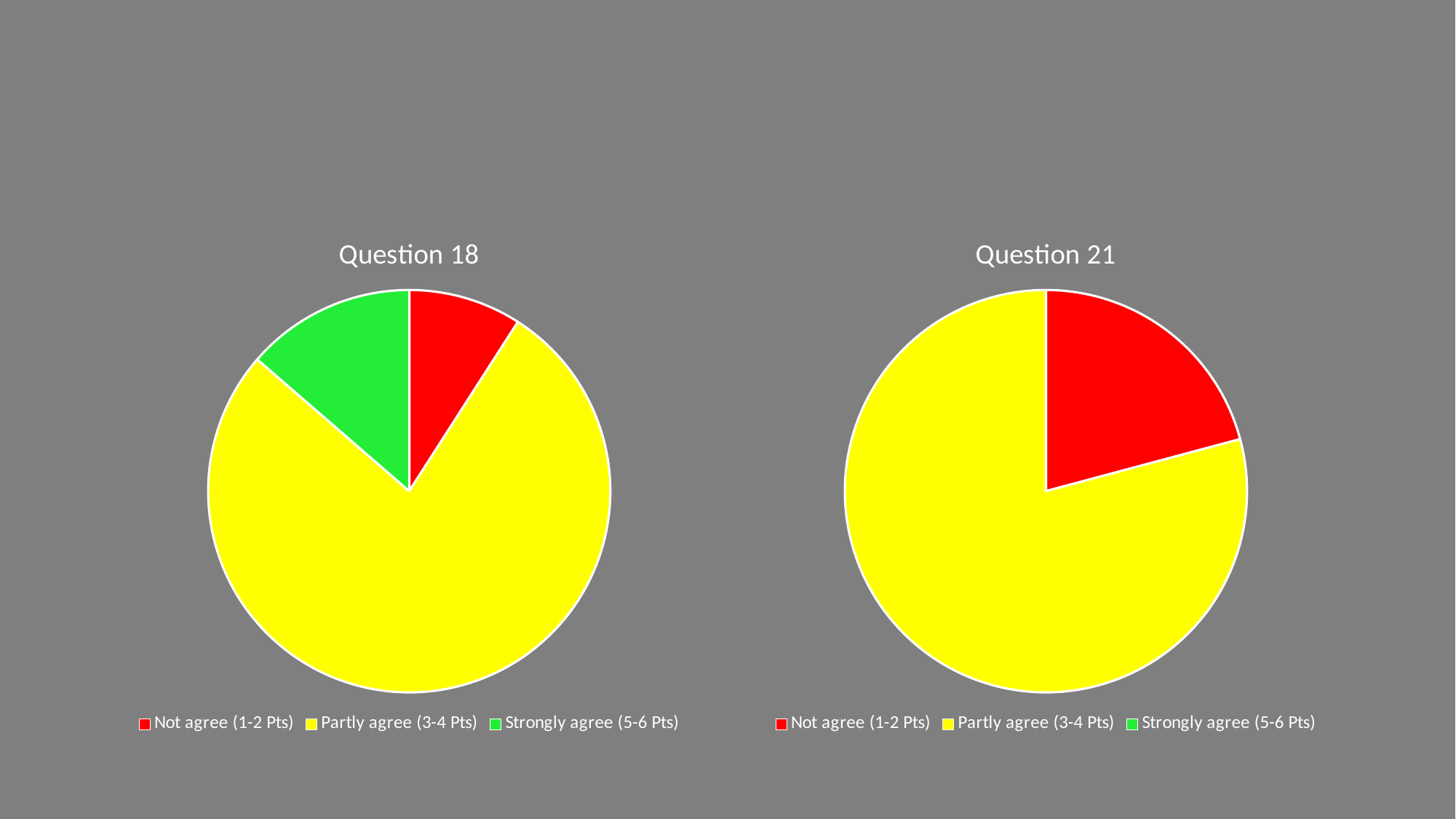
What kind of chart is used for Question 18? pie chart In the Question 21 chart, which category has the largest slice? Partly agree (3-4 Pts) How many slices are visible in the Question 21 pie chart? 2 What is the title of the chart on the right side of the slide? Question 21 How many slices are visible in the Question 18 pie chart? 3 In the Question 21 chart, which slice is larger: Partly agree (3-4 Pts) or Not agree (1-2 Pts)? Partly agree (3-4 Pts) In the Question 18 chart, which slice is larger: Strongly agree (5-6 Pts) or Not agree (1-2 Pts)? Strongly agree (5-6 Pts) What colour represents Strongly agree (5-6 Pts) in the Question 18 chart? green In the Question 18 chart, which category has the largest slice? Partly agree (3-4 Pts) How many categories does the legend of the Question 18 chart list? 3 What kind of chart is used for Question 21? pie chart In the Question 18 chart, which category has the smallest slice? Not agree (1-2 Pts)